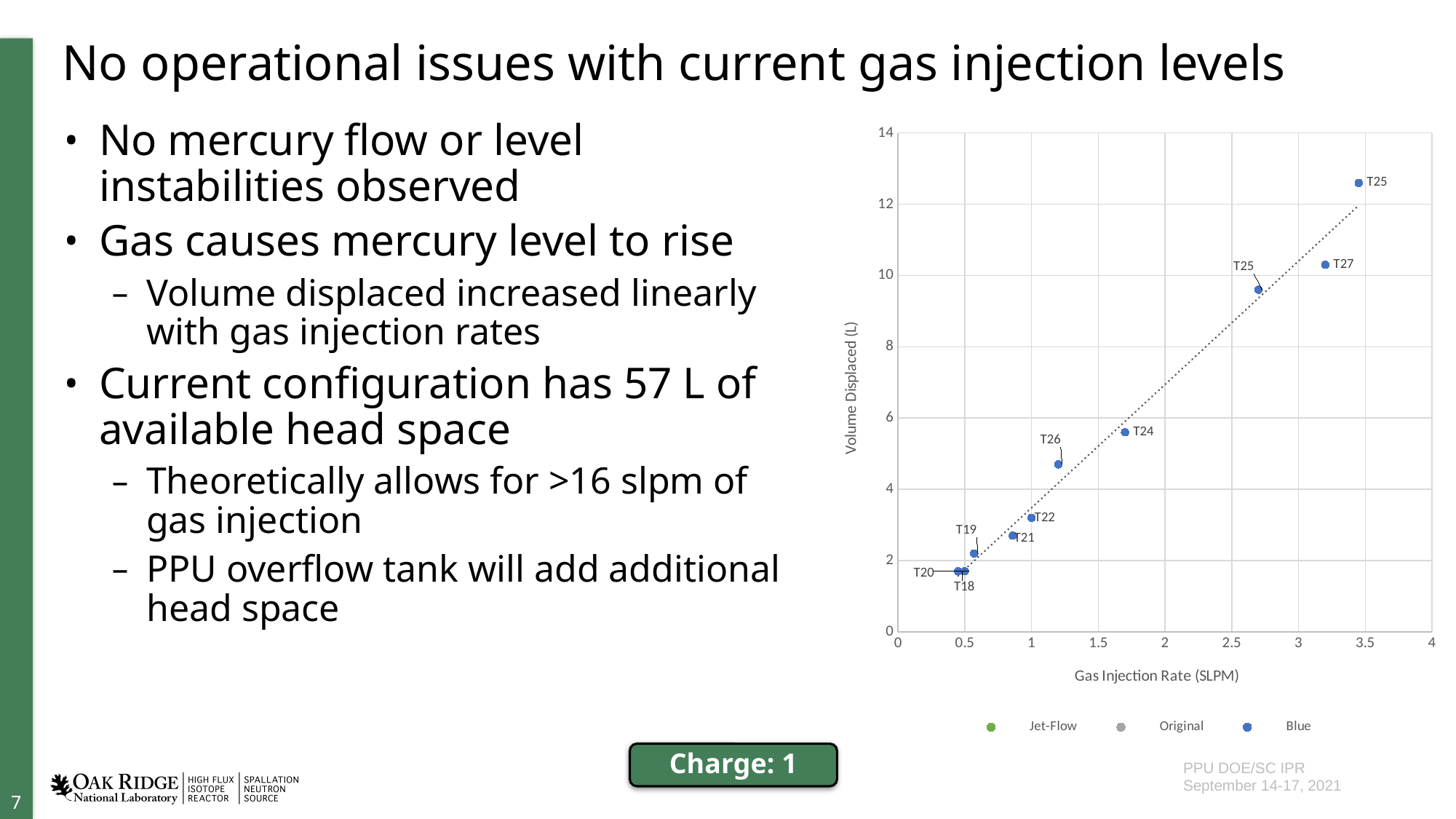
Is the volume displaced for T22 greater or less than 4? less Which point has a larger volume displaced, T24 or T26? T24 How many series does the chart legend list? 3 Does the volume displaced rise or fall as the gas injection rate increases? rise What is the title of the y axis of the chart? Volume Displaced (L) Is the volume displaced for T18 greater or less than 2? less Is the volume displaced for T24 greater or less than 4? greater Which labeled point has the highest volume displaced? T25 What kind of chart is shown on the slide? scatter chart What is the title of the x axis of the chart? Gas Injection Rate (SLPM)